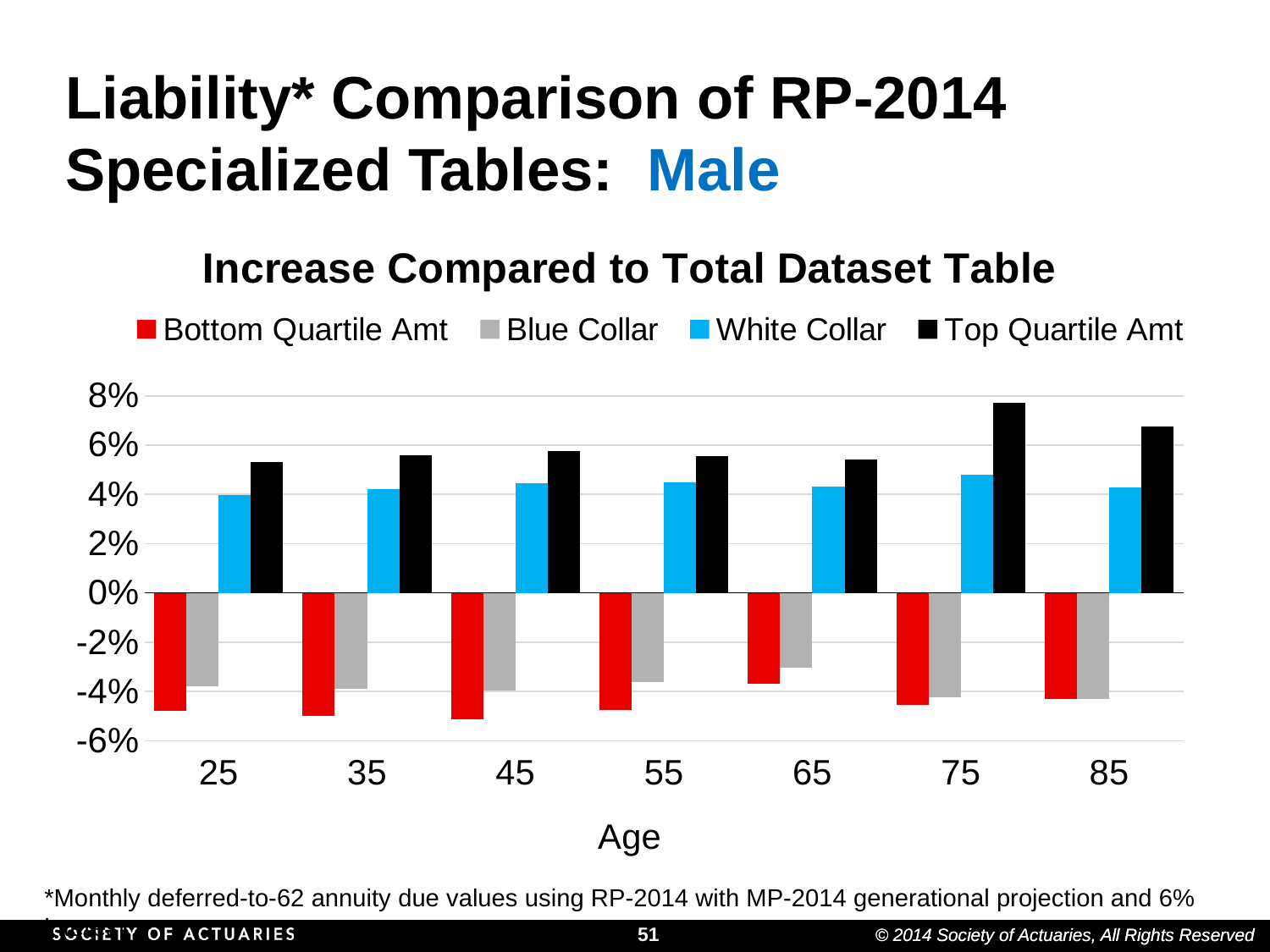
Is the Blue Collar value at age 65 greater or less than -4%? greater What is the title of the chart? Increase Compared to Total Dataset Table Is the Top Quartile Amt value at age 25 greater or less than 6%? less At which age is the Blue Collar value closest to zero (least negative)? 65 At age 75, which is larger: the Top Quartile Amt value or the White Collar value? Top Quartile Amt Is the Bottom Quartile Amt value at age 45 greater or less than -4%? less How many age categories are shown on the x axis? 7 How many series does the legend list? 4 What kind of chart is shown on the slide? bar chart Which colour represents the Top Quartile Amt series? black At which age is the Top Quartile Amt value highest? 75